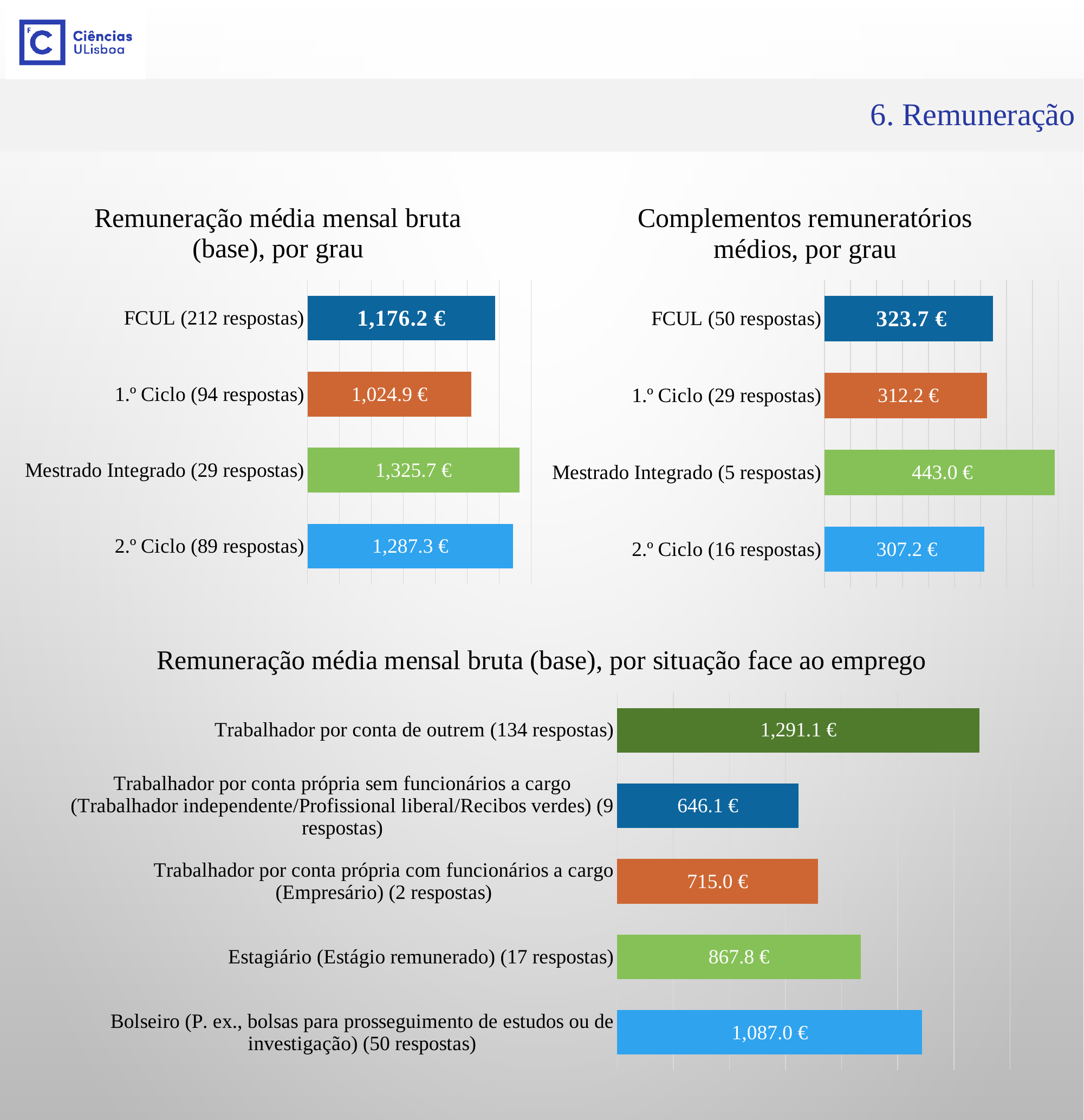
In the chart 'Remuneração média mensal bruta (base), por grau', how many categories are shown? 4 In the chart 'Remuneração média mensal bruta (base), por grau', which category has the lowest value? 1.º Ciclo (94 respostas) In the chart 'Remuneração média mensal bruta (base), por situação face ao emprego', which is larger: Bolseiro or Estagiário? Bolseiro In the chart 'Remuneração média mensal bruta (base), por grau', what is the value for Mestrado Integrado? 1,325.7 € In the chart 'Remuneração média mensal bruta (base), por situação face ao emprego', which category has the lowest value? Trabalhador por conta própria sem funcionários a cargo (Trabalhador independente/Profissional liberal/Recibos verdes) (9 respostas) In the chart 'Remuneração média mensal bruta (base), por situação face ao emprego', how many categories are shown? 5 In the chart 'Remuneração média mensal bruta (base), por situação face ao emprego', what is the value for Estagiário (Estágio remunerado)? 867.8 € In the chart 'Complementos remuneratórios médios, por grau', what is the value for FCUL? 323.7 € In the chart 'Complementos remuneratórios médios, por grau', which category has the highest value? Mestrado Integrado (5 respostas) In the chart 'Complementos remuneratórios médios, por grau', what is the difference between Mestrado Integrado and 2.º Ciclo? 135.8 € In the chart 'Remuneração média mensal bruta (base), por grau', what is the difference between Mestrado Integrado and 1.º Ciclo? 300.8 € In the chart 'Complementos remuneratórios médios, por grau', what kind of chart is used? Bar chart